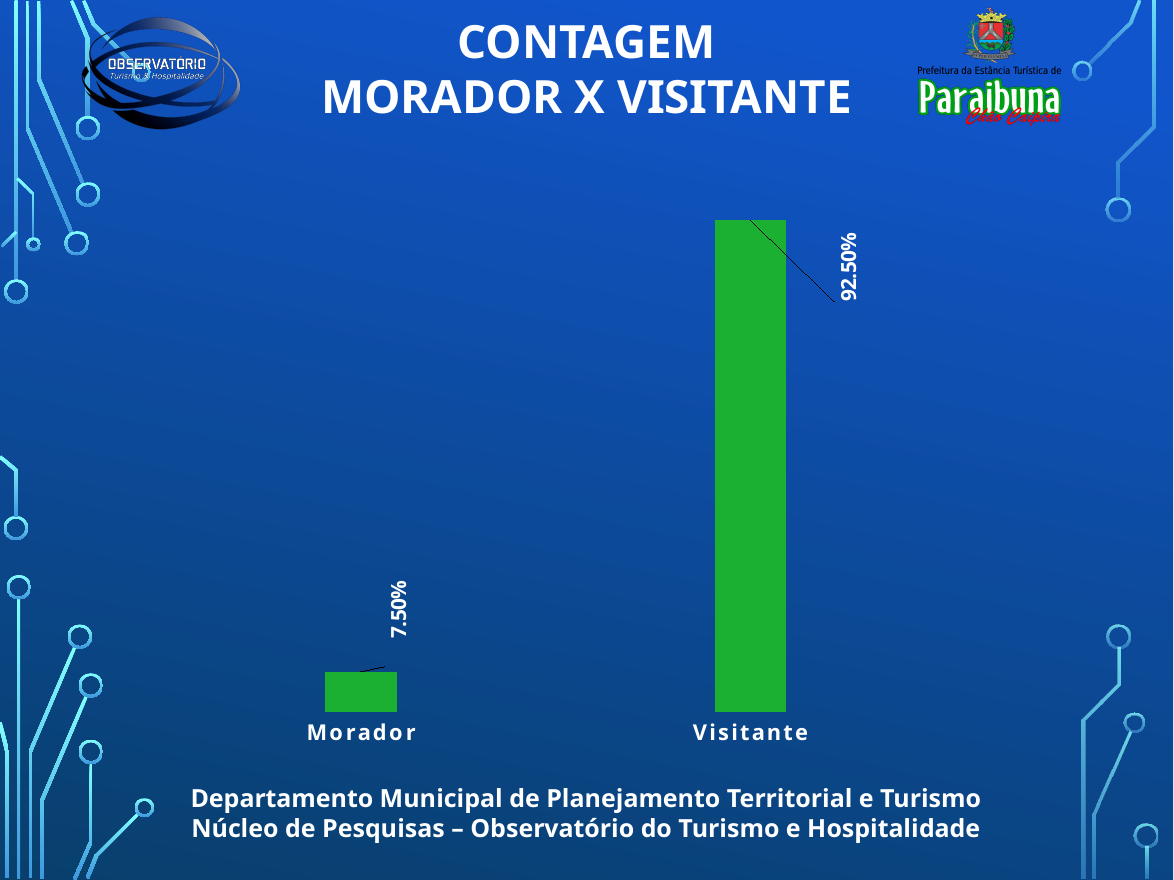
What colour are the bars in the chart? Green What is the title of the chart on the slide? CONTAGEM MORADOR X VISITANTE What is the total of the two values shown in the chart? 100.00% Which category has the lowest value? Morador What is the value for Visitante? 92.50% What is the difference between the values for Visitante and Morador? 85.00% How many categories are shown in the chart? 2 Which is larger, the value for Morador or the value for Visitante? Visitante What is the value for Morador? 7.50% Which category has the highest value? Visitante What kind of chart is shown on the slide? Bar chart